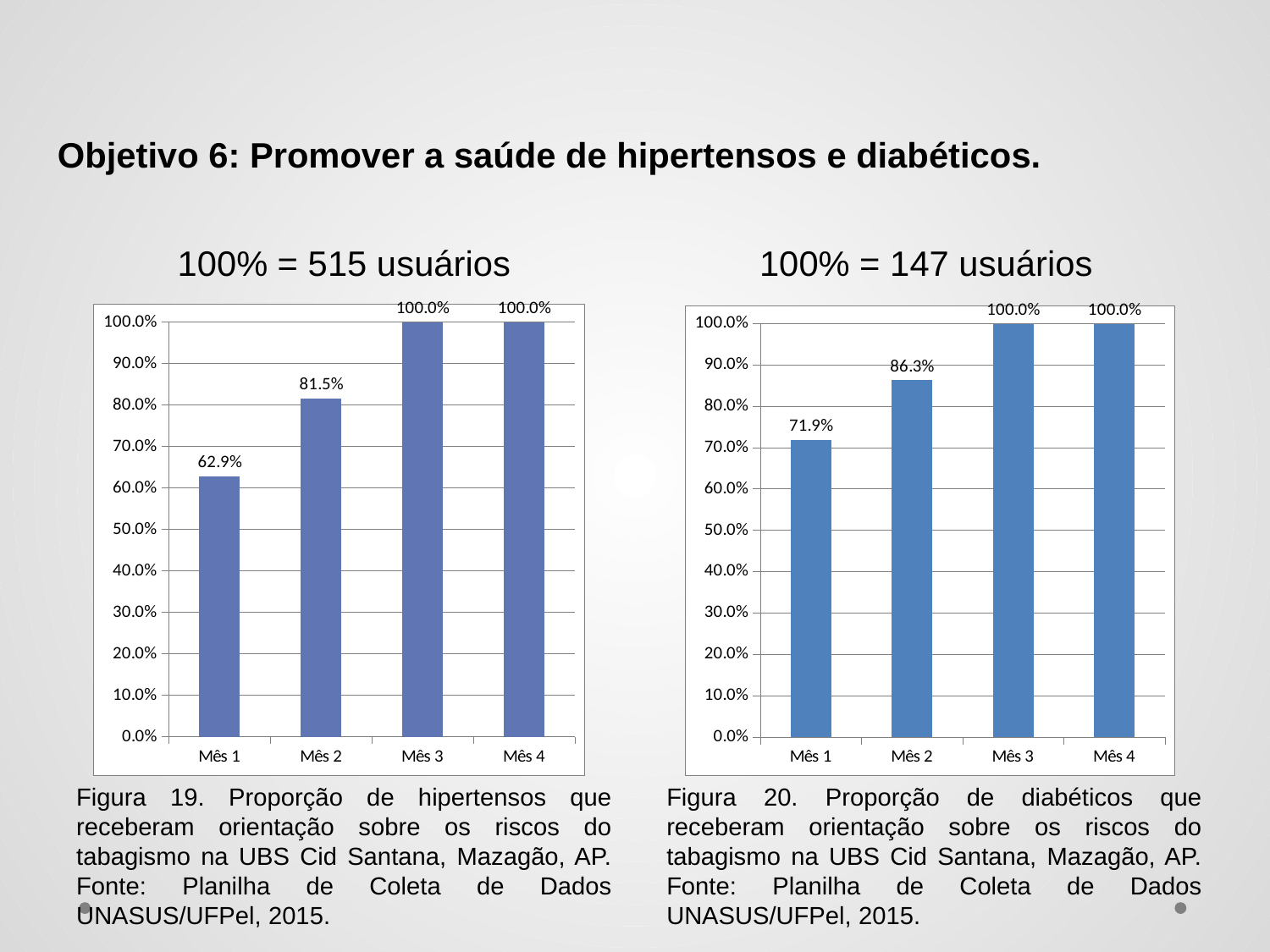
In the left chart (Figura 19, hipertensos), what is the value for Mês 2? 81.5% How many months (categories) are shown in the left chart (Figura 19)? 4 In the right chart (Figura 20, diabéticos), what is the difference between the values for Mês 3 and Mês 2? 13.7% In the right chart (Figura 20, diabéticos), do the values rise or fall from Mês 1 to Mês 4? Rise In the left chart (Figura 19, hipertensos), what is the value for Mês 1? 62.9% Which is larger: the Mês 1 value in the left chart (hipertensos) or the Mês 1 value in the right chart (diabéticos)? Right chart (diabéticos), 71.9% In the right chart (Figura 20, diabéticos), what is the value for Mês 1? 71.9% In the left chart (Figura 19, hipertensos), what is the difference between the values for Mês 2 and Mês 1? 18.6% In the right chart (Figura 20, diabéticos), what is the value for Mês 2? 86.3% What type of chart is Figura 20 (the right chart)? Bar chart In the left chart (Figura 19, hipertensos), which month has the lowest value? Mês 1 In the right chart (Figura 20, diabéticos), which month has the lowest value? Mês 1